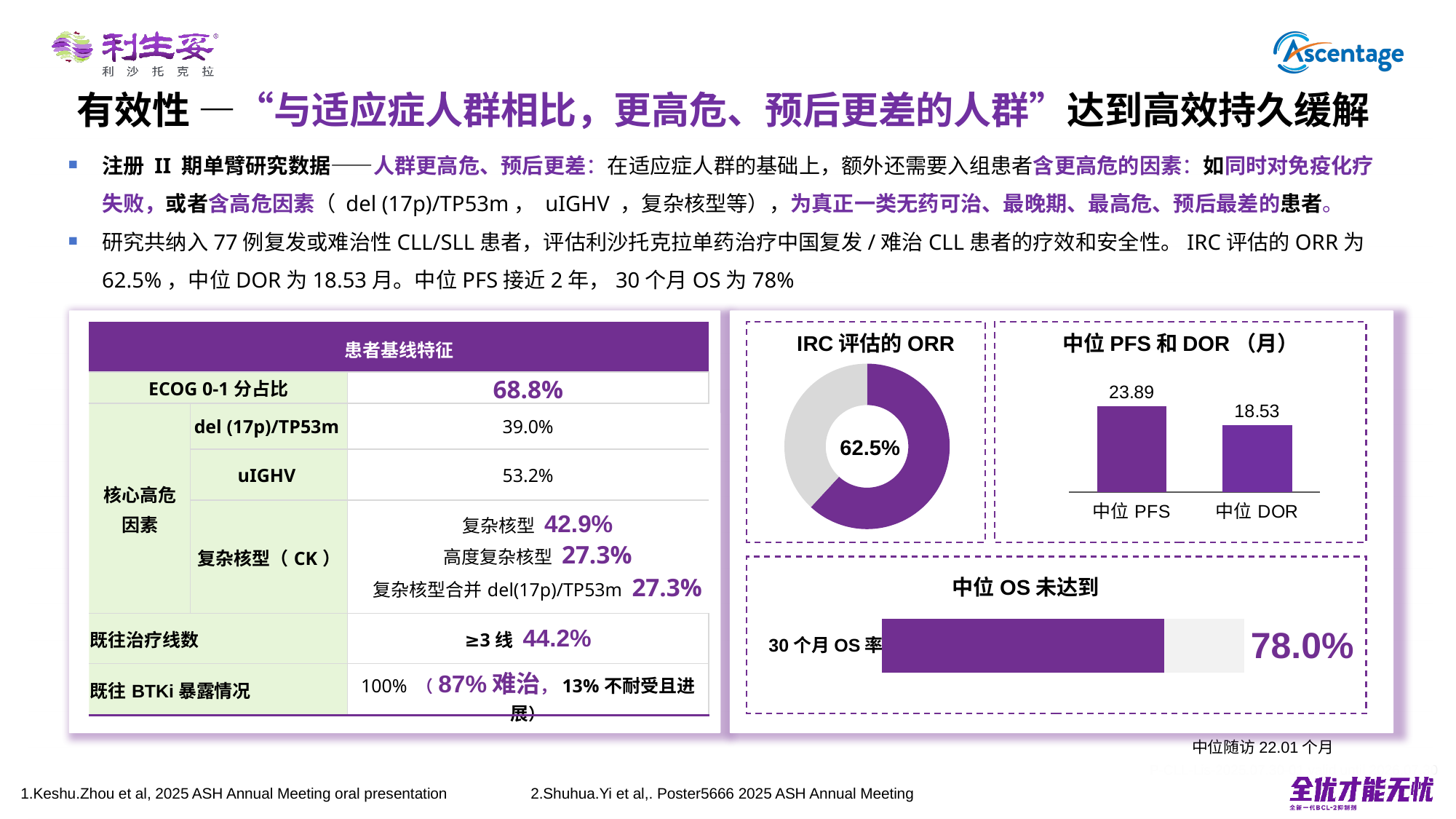
In the chart titled "中位 OS 未达到", is the value for 30 个月 OS 率 greater or less than 50%? greater What colour are the bars in the chart titled "中位 PFS 和 DOR（月）"? Purple In the chart titled "IRC 评估的 ORR", what value is shown in the centre of the donut? 62.5% In the chart titled "中位 PFS 和 DOR（月）", how many categories are plotted? 2 In the chart titled "中位 PFS 和 DOR（月）", which category has the higher value? 中位 PFS In the chart titled "中位 PFS 和 DOR（月）", which category has the lower value? 中位 DOR What kind of chart is the one titled "IRC 评估的 ORR"? Donut chart In the chart titled "中位 PFS 和 DOR（月）", what is the difference between 中位 PFS and 中位 DOR? 5.36 In the chart titled "中位 PFS 和 DOR（月）", what is the value for 中位 PFS? 23.89 In the chart titled "中位 OS 未达到", what is the value for 30 个月 OS 率? 78.0% In the chart titled "中位 PFS 和 DOR（月）", what is the value for 中位 DOR? 18.53 What kind of chart is the one titled "中位 PFS 和 DOR（月）"? Bar chart